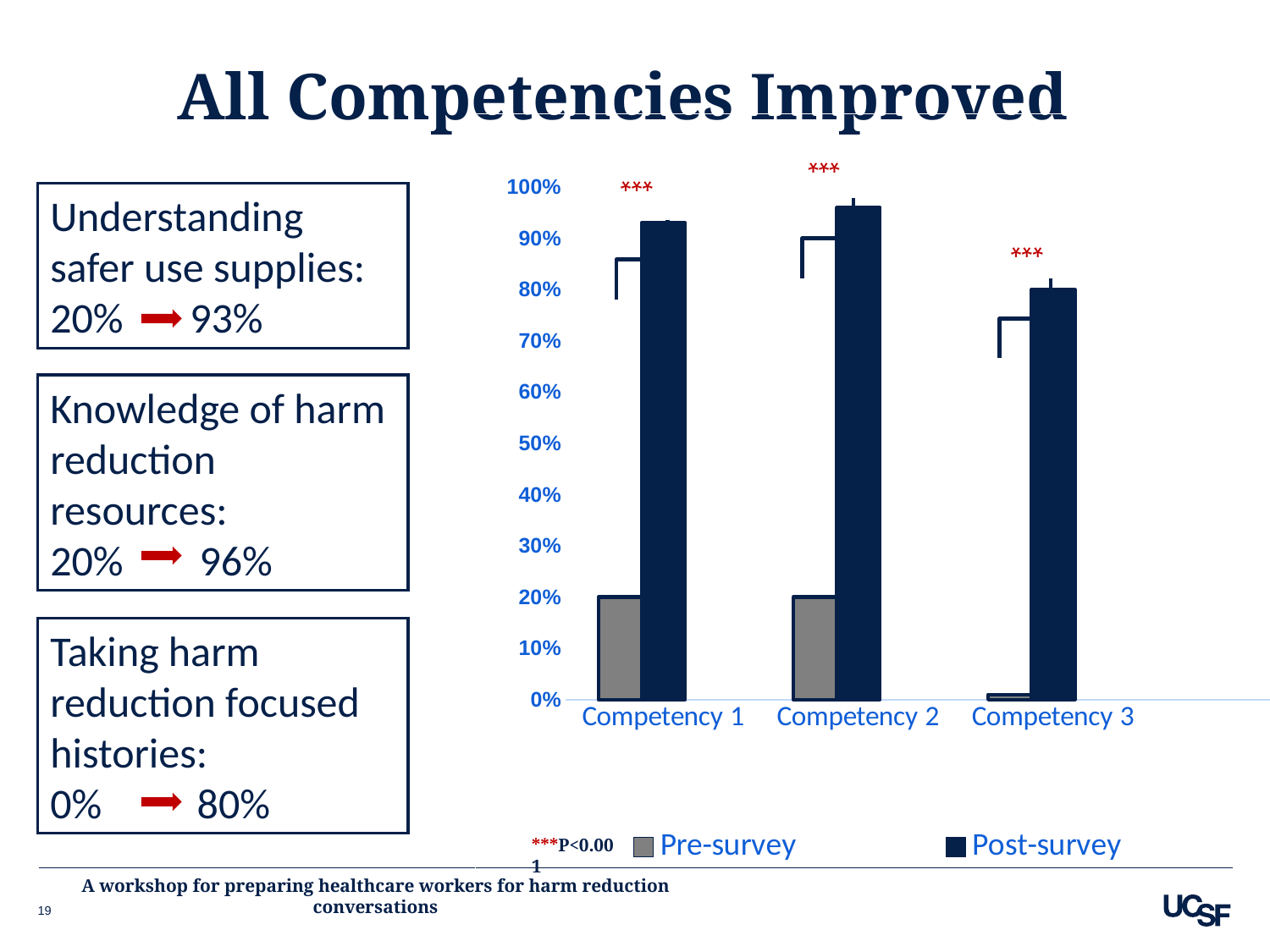
What is the Pre-survey value for Competency 3? 0% For Competency 2, which is larger, the Pre-survey or the Post-survey value? Post-survey Is the Post-survey value for Competency 1 greater or less than 90%? greater How many categories are shown on the x axis of the chart? 3 Which competency has the lowest Post-survey value? Competency 3 What is the title of the slide containing the chart? All Competencies Improved What kind of chart is shown on the slide? bar chart Is the Post-survey value for Competency 3 greater or less than 90%? less Which series is shown in grey in the chart? Pre-survey What is the Pre-survey value for Competency 1? 20% Which competency has the highest Post-survey value? Competency 2 How many series does the chart legend list? 2